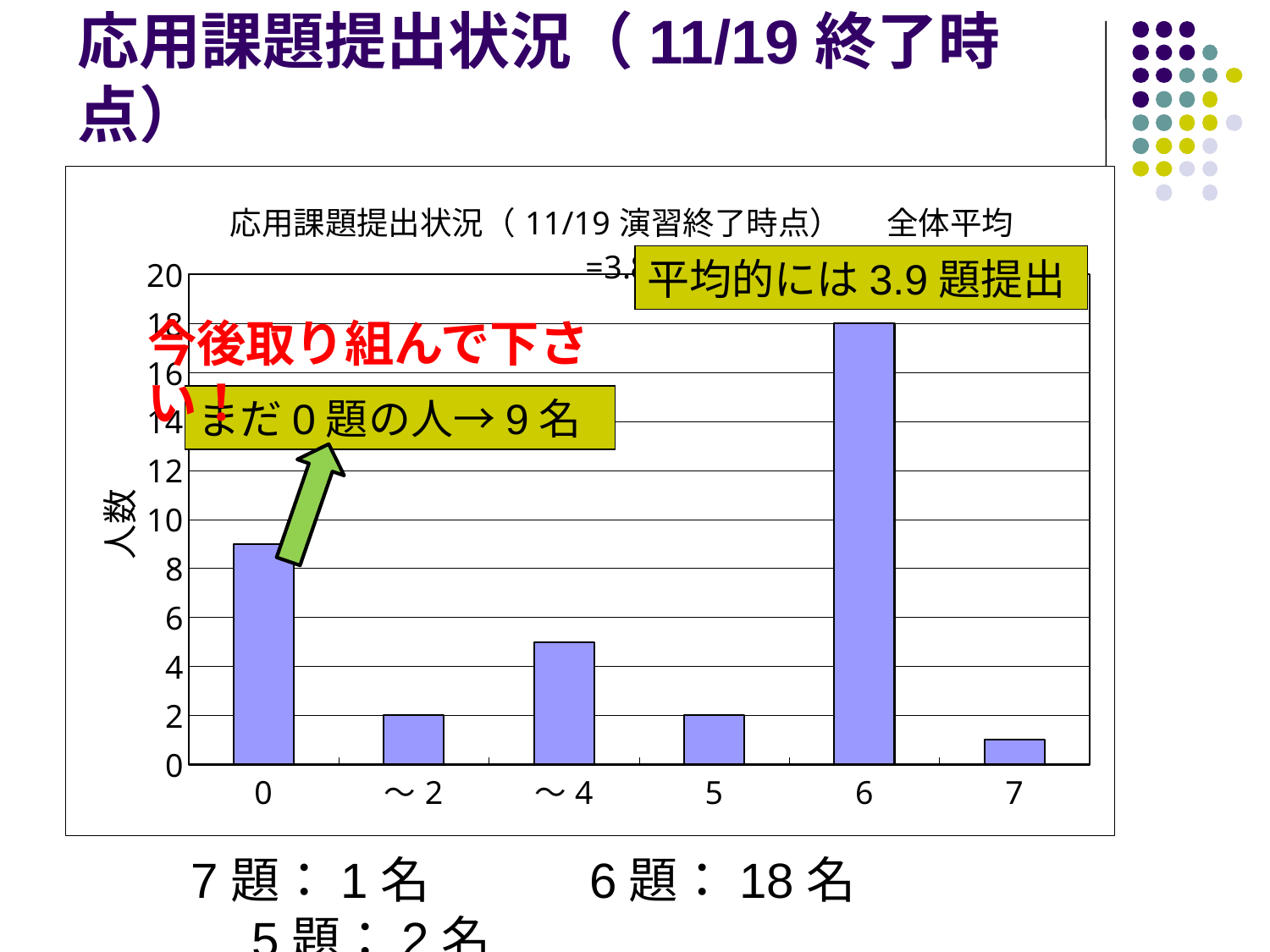
How many people (人数) are in the category ～2? 2 What is the difference between the number of people in category 6 and category 0? 9 Which category has more people, ～2 or ～4? ～4 Which category has the lowest bar? 7 Which category has the highest bar? 6 How many categories are shown on the x axis of the chart? 6 How many people (人数) are in the category 5? 2 Is the value for ～4 greater or less than 4? greater How many people (人数) are in the category 7? 1 How many people (人数) are in the category 0? 9 What kind of chart is shown on the slide? bar chart How many people (人数) are in the category 6? 18